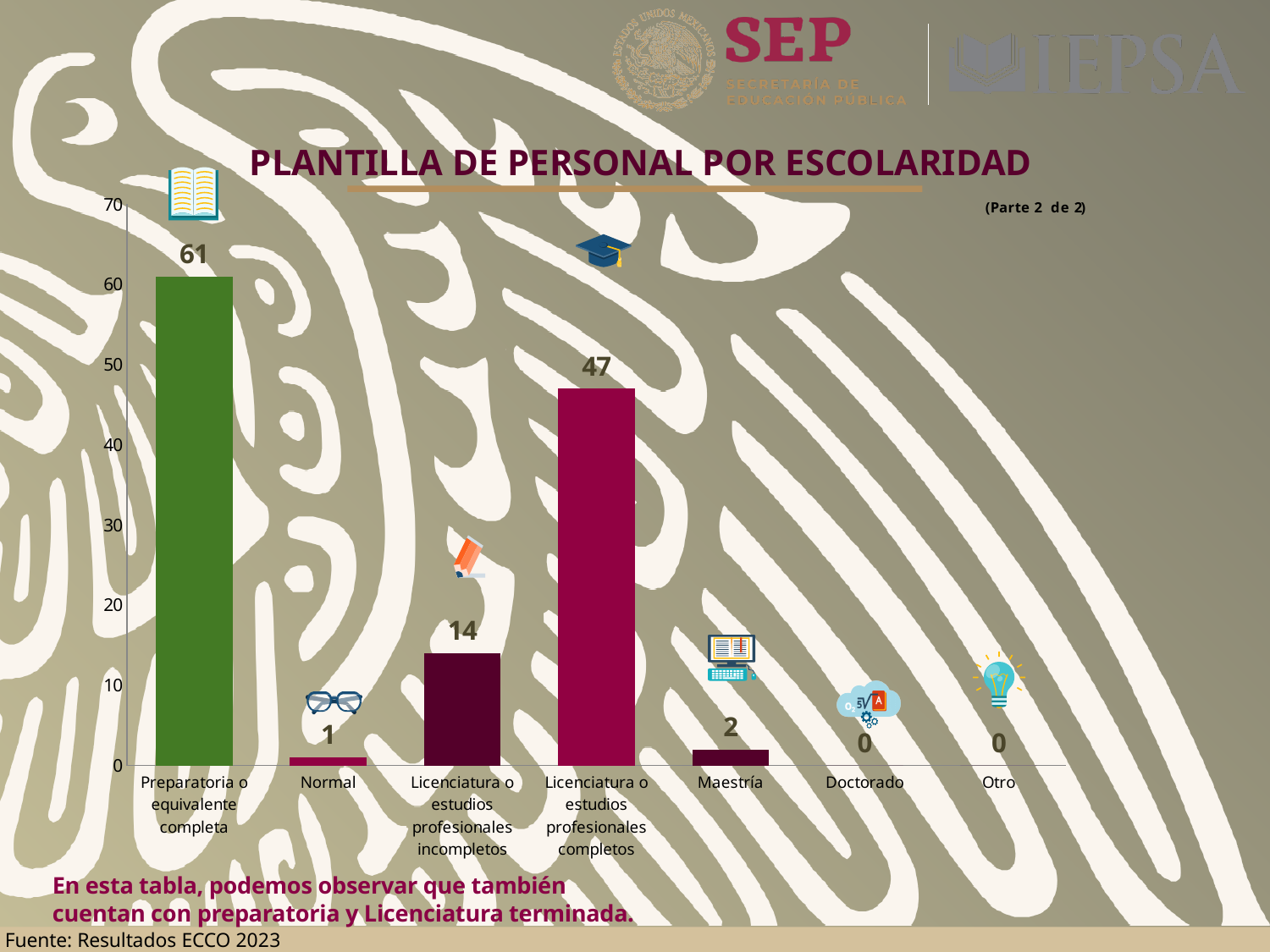
Which is larger, the value for Normal or the value for Maestría? Maestría What kind of chart is shown on the slide? Bar chart How many categories are shown on the x axis? 7 What is the value for Licenciatura o estudios profesionales incompletos? 14 What is the value for Preparatoria o equivalente completa? 61 What is the value for Maestría? 2 Which category has the highest value? Preparatoria o equivalente completa What is the value for Licenciatura o estudios profesionales completos? 47 What is the difference between the values for Licenciatura o estudios profesionales incompletos and Maestría? 12 What is the title of the chart? PLANTILLA DE PERSONAL POR ESCOLARIDAD What is the difference between the values for Preparatoria o equivalente completa and Licenciatura o estudios profesionales completos? 14 What is the value for Doctorado? 0